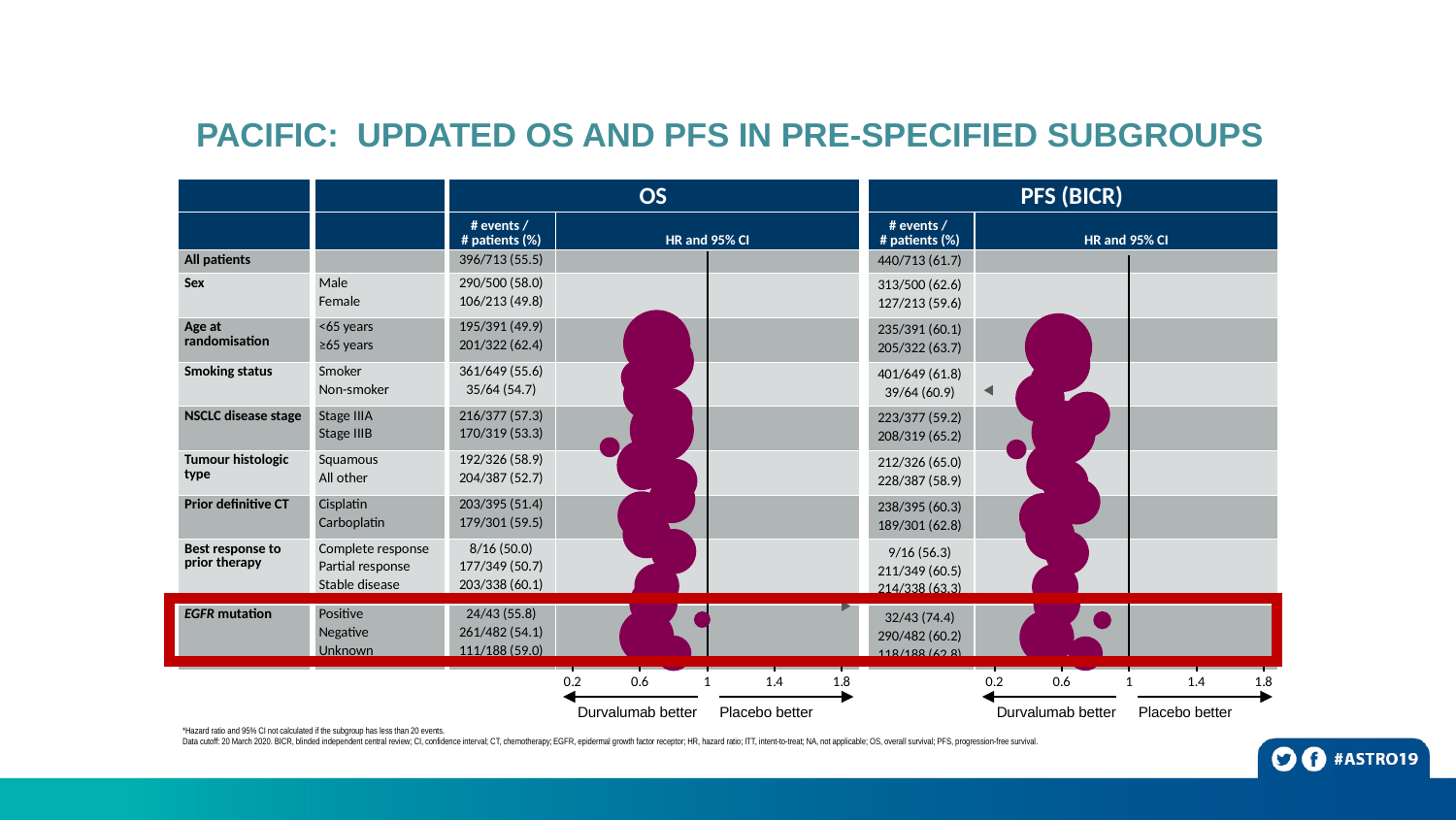
In the PFS (BICR) panel, what is the '# events / # patients (%)' value for EGFR mutation Positive? 32/43 (74.4) In the PFS (BICR) panel, what is the '# events / # patients (%)' value for All patients? 440/713 (61.7) In the OS panel, what is the '# events / # patients (%)' value for Complete response? 8/16 (50.0) What is the highest tick value shown on the HR axis of the forest plots? 1.8 What kind of chart is used to display the HR and 95% CI on this slide? Forest plot In the OS panel, what is the '# events / # patients (%)' value for All patients? 396/713 (55.5) How many forest plot panels are shown on the slide? 2 In the OS panel, what is the '# events / # patients (%)' value for Male patients? 290/500 (58.0) In the OS panel, what is the '# events / # patients (%)' value for Non-smokers? 35/64 (54.7) In the PFS (BICR) panel, what is the '# events / # patients (%)' value for Stage IIIB? 208/319 (65.2) In the OS panel, which has the higher event percentage, Male or Female patients? Male What value does the vertical reference line in each forest plot mark on the HR axis? 1